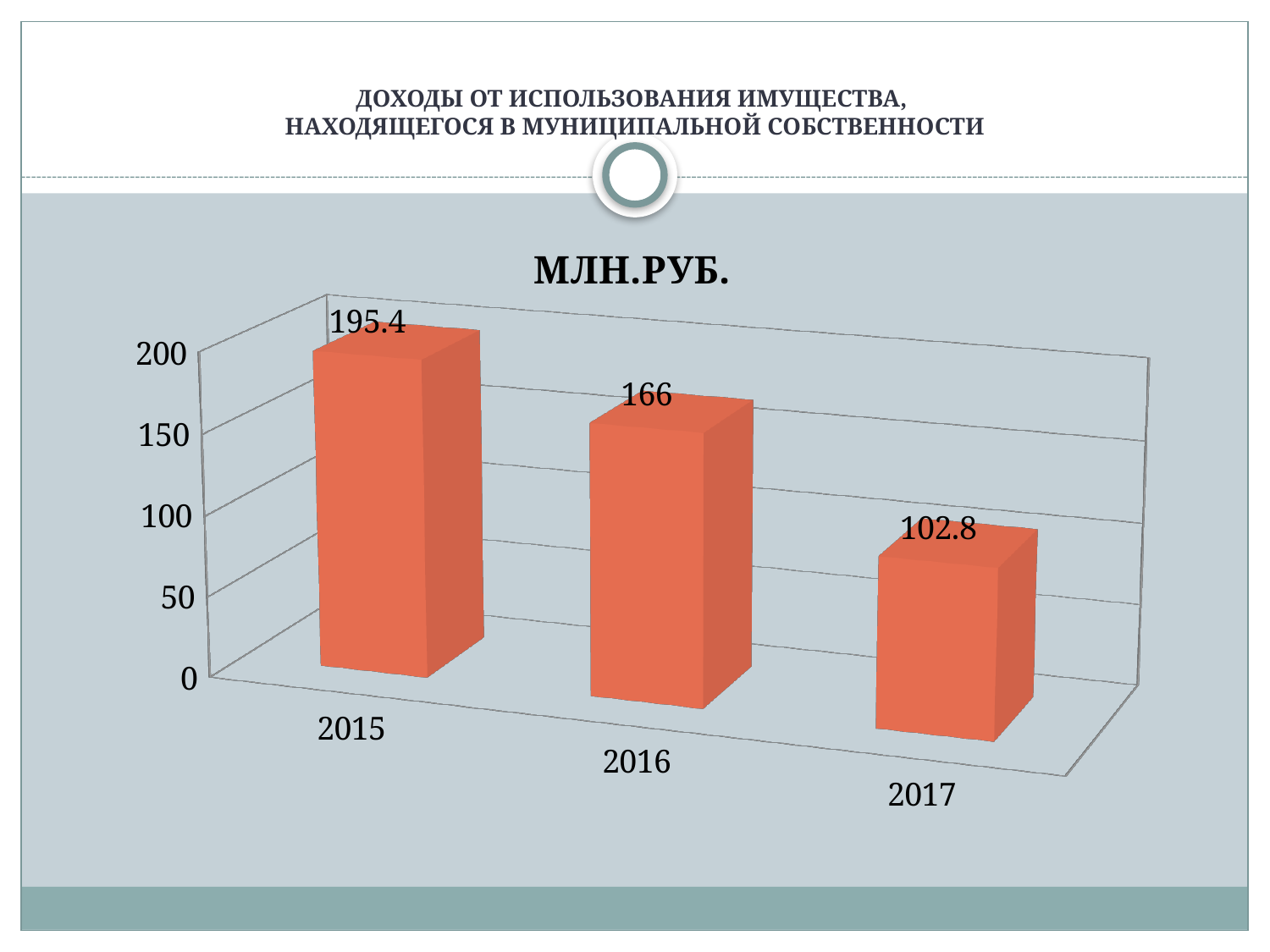
What kind of chart is shown on the slide? bar chart Do the values rise or fall from 2015 to 2017? fall What is the value for 2016? 166 What is the value for 2015? 195.4 Which year has the lowest value? 2017 What is the value for 2017? 102.8 Which is larger, the value for 2016 or the value for 2017? 2016 What is the difference between the values for 2015 and 2017? 92.6 Is the value for 2017 greater or less than 150? less How many years are shown on the chart? 3 What is the difference between the values for 2015 and 2016? 29.4 Which year has the highest value? 2015